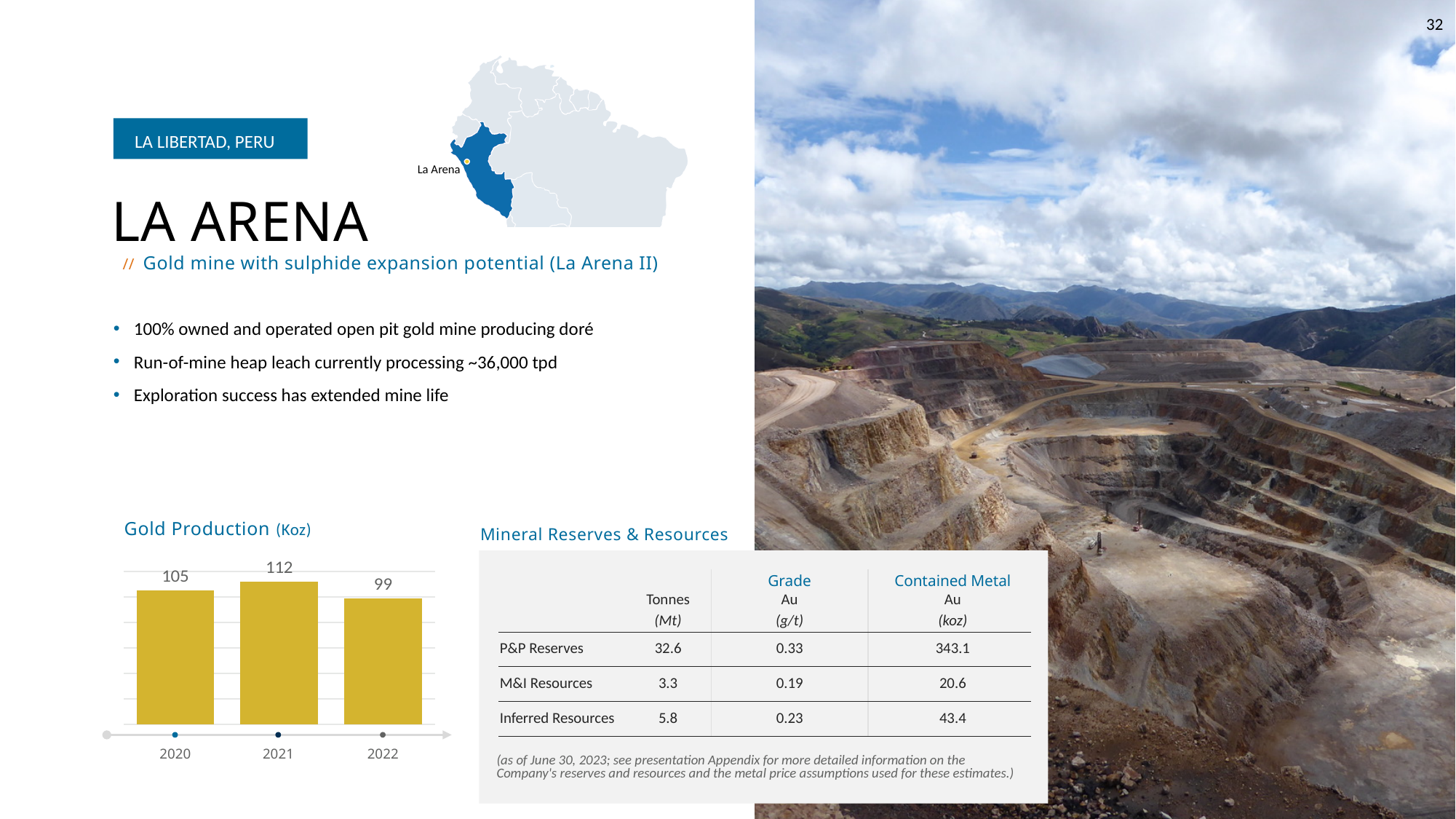
Which year has the lowest gold production in the Gold Production chart? 2022 In the Gold Production chart, does gold production rise or fall from 2021 to 2022? Fall What is the gold production value for 2022 in the Gold Production chart? 99 How many years are shown in the Gold Production chart? 3 What is the difference in gold production between 2021 and 2022 in the Gold Production chart? 13 Which year has the highest gold production in the Gold Production chart? 2021 In the Gold Production chart, is the value for 2020 or 2022 larger? 2020 What is the difference in gold production between 2021 and 2020 in the Gold Production chart? 7 What type of chart is the Gold Production chart? Bar chart What is the gold production value for 2021 in the Gold Production chart? 112 What is the gold production value for 2020 in the Gold Production chart? 105 What unit is given in the title of the Gold Production chart? Koz